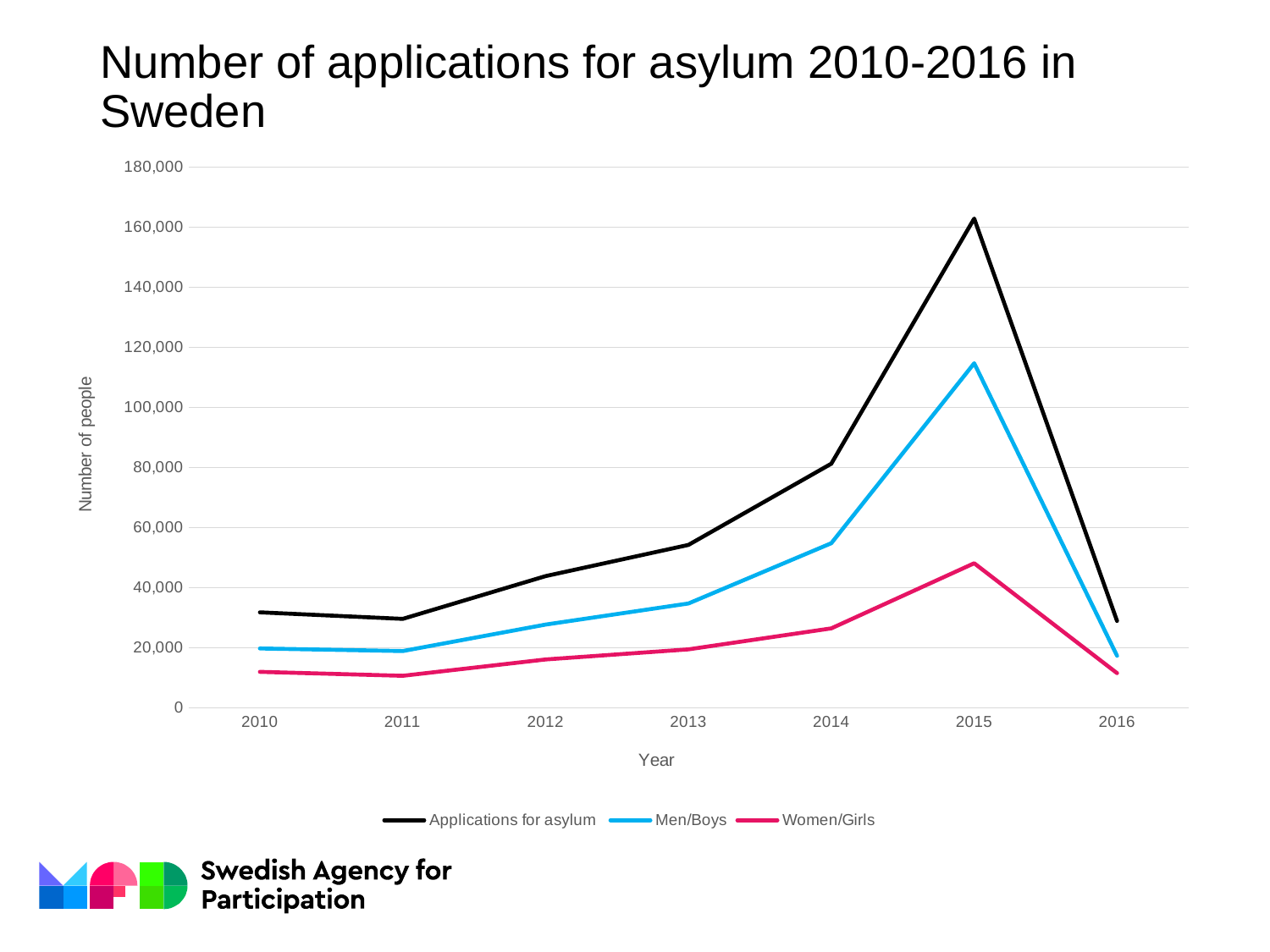
In which year is the value for Men/Boys highest? 2015 Which is larger in 2015, the value for Men/Boys or the value for Women/Girls? Men/Boys How many years are plotted along the x axis? 7 How many series does the legend list? 3 Do the values for Applications for asylum rise or fall from 2011 to 2015? Rise Is the value for Men/Boys in 2015 greater or less than 100,000? greater Is the value for Applications for asylum in 2010 greater or less than 40,000? less What kind of chart is shown on the slide? Line chart Is the value for Women/Girls in 2015 greater or less than 40,000? greater What is the title of the vertical axis? Number of people In which year is the value for Applications for asylum highest? 2015